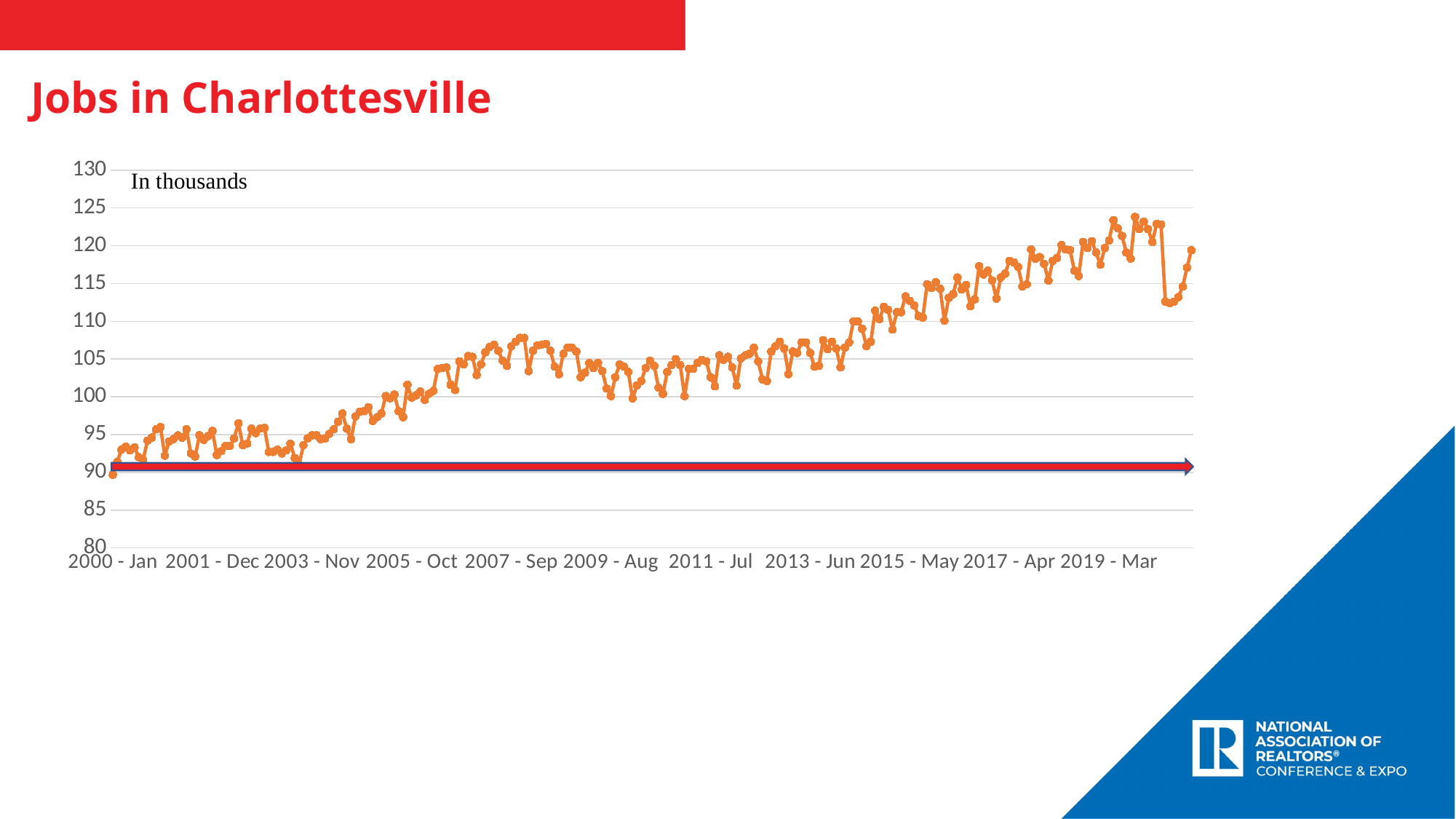
Is the highest value on the chart greater or less than 120? greater Overall, do the values rise or fall from 2000 - Jan to 2019 - Mar? rise In what units are the values on the chart expressed, according to the note on the chart? In thousands Is the value for 2007 - Sep greater or less than 100? greater Which is larger, the value for 2019 - Mar or the value for 2009 - Aug? 2019 - Mar Is the value for 2001 - Dec greater or less than 100? less What kind of chart is shown on the slide? line chart What is the title of the chart? Jobs in Charlottesville